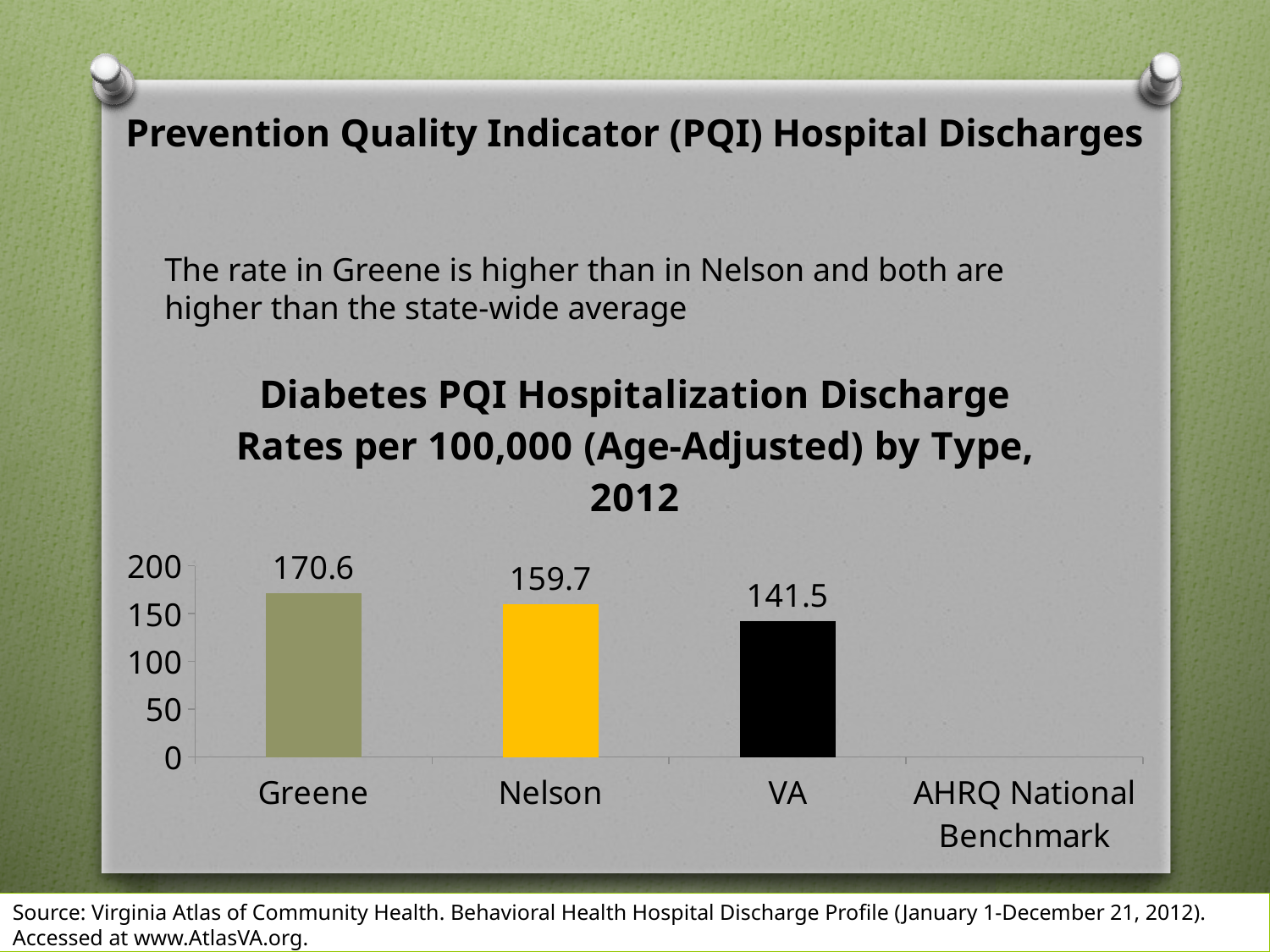
How many bars are plotted in the chart? 3 What is the value for Nelson? 159.7 What is the difference between the values for Greene and Nelson? 10.9 What is the difference between the values for Nelson and VA? 18.2 Is the value for VA greater or less than 150? less What is the value for VA? 141.5 What kind of chart is shown? bar chart Do the plotted values rise or fall from left to right along the x axis? fall Which of the plotted bars has the lowest value? VA Which is larger, the value for Greene or the value for VA? Greene Which category has the highest value? Greene What is the value for Greene? 170.6